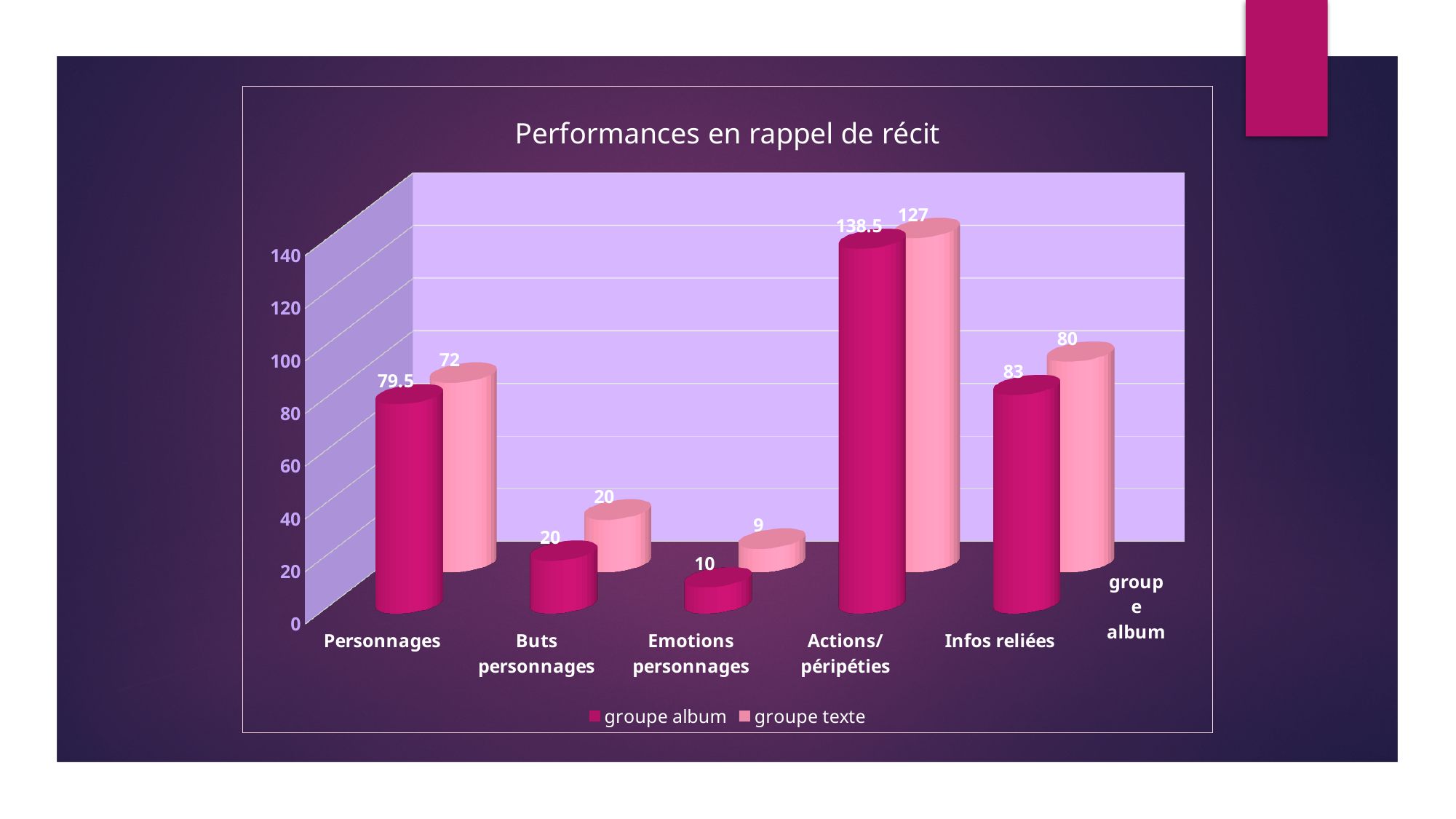
In the Infos reliées category, which series has the larger value, groupe album or groupe texte? groupe album Which category has the highest value for groupe album? Actions/péripéties What is the title of the chart? Performances en rappel de récit What is the difference between groupe album and groupe texte in the Personnages category? 7.5 What is the value for groupe album in the Personnages category? 79.5 What is the value for groupe texte in the Actions/péripéties category? 127 How many series does the legend list? 2 What type of chart is shown on the slide? bar chart How many categories are shown on the x axis? 5 Which category has the lowest value for groupe texte? Emotions personnages What is the value for groupe texte in the Emotions personnages category? 9 What is the difference between groupe album and groupe texte in the Actions/péripéties category? 11.5